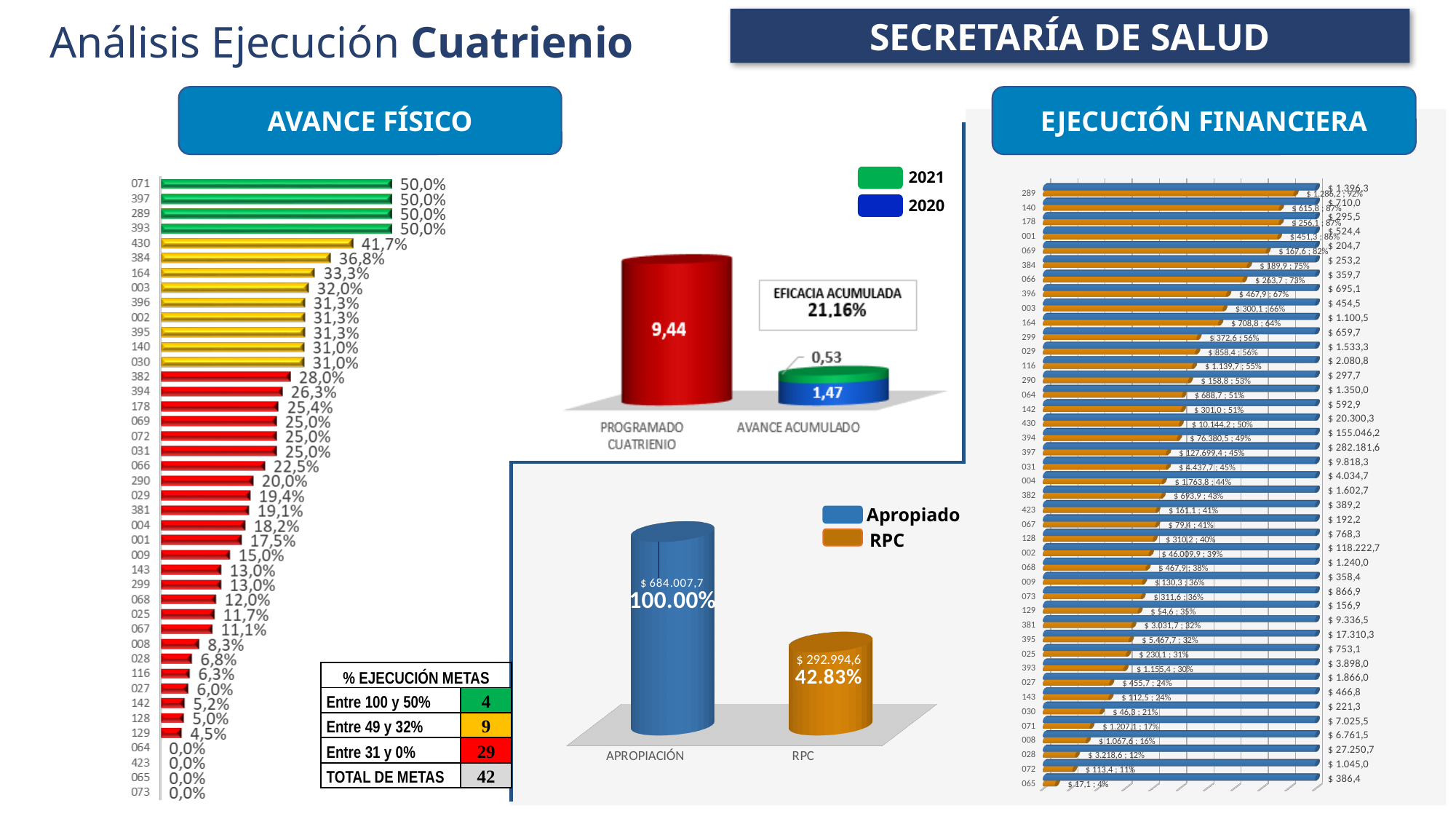
How many categories are plotted in the AVANCE FÍSICO chart? 42 How many series does the legend of the PROGRAMADO CUATRIENIO / AVANCE ACUMULADO chart list? 2 In the AVANCE FÍSICO chart, what is the difference between the values for category 071 and category 430? 8,3% In the AVANCE FÍSICO chart, what is the value for category 382? 28,0% In the AVANCE FÍSICO chart, what is the value for category 430? 41,7% In the EJECUCIÓN FINANCIERA chart, what is the Apropiado value for category 289? $ 1.396,3 In the AVANCE FÍSICO chart, which has the larger value, category 382 or category 290? 382 In the PROGRAMADO CUATRIENIO / AVANCE ACUMULADO chart, what is the value of the PROGRAMADO CUATRIENIO bar? 9,44 In the APROPIACIÓN / RPC chart, what value is shown for RPC? $ 292.994,6 What kind of chart is the EJECUCIÓN FINANCIERA chart? bar chart In the PROGRAMADO CUATRIENIO / AVANCE ACUMULADO chart, what is the 2021 value shown on the AVANCE ACUMULADO bar? 0,53 In the APROPIACIÓN / RPC chart, what percentage is shown for RPC? 42.83%